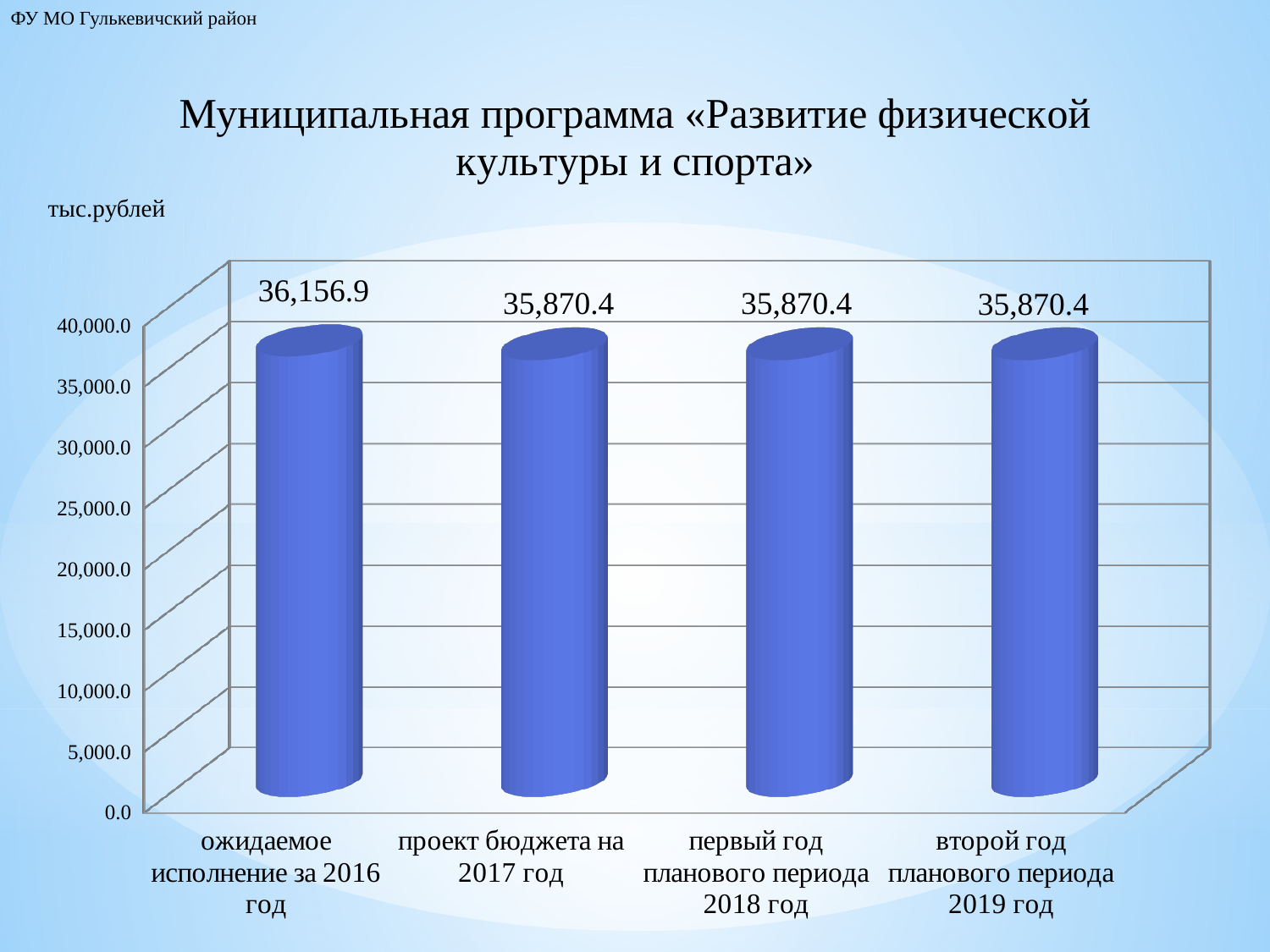
How many categories are shown on the x axis? 4 What kind of chart is shown on the slide? bar chart Which category has the highest value? ожидаемое исполнение за 2016 год Do the values rise or fall from the 2016 category to the 2017 category? fall What is the value for «проект бюджета на 2017 год»? 35,870.4 What is the value for «второй год планового периода 2019 год»? 35,870.4 Is the value for «второй год планового периода 2019 год» greater or less than 30,000.0? greater Which is larger: the value for «ожидаемое исполнение за 2016 год» or the value for «проект бюджета на 2017 год»? ожидаемое исполнение за 2016 год What is the difference between the value for 2016 (ожидаемое исполнение) and the value for 2017 (проект бюджета)? 286.5 What is the value for «ожидаемое исполнение за 2016 год»? 36,156.9 What is the value for «первый год планового периода 2018 год»? 35,870.4 In what units are the values on the chart expressed? тыс.рублей